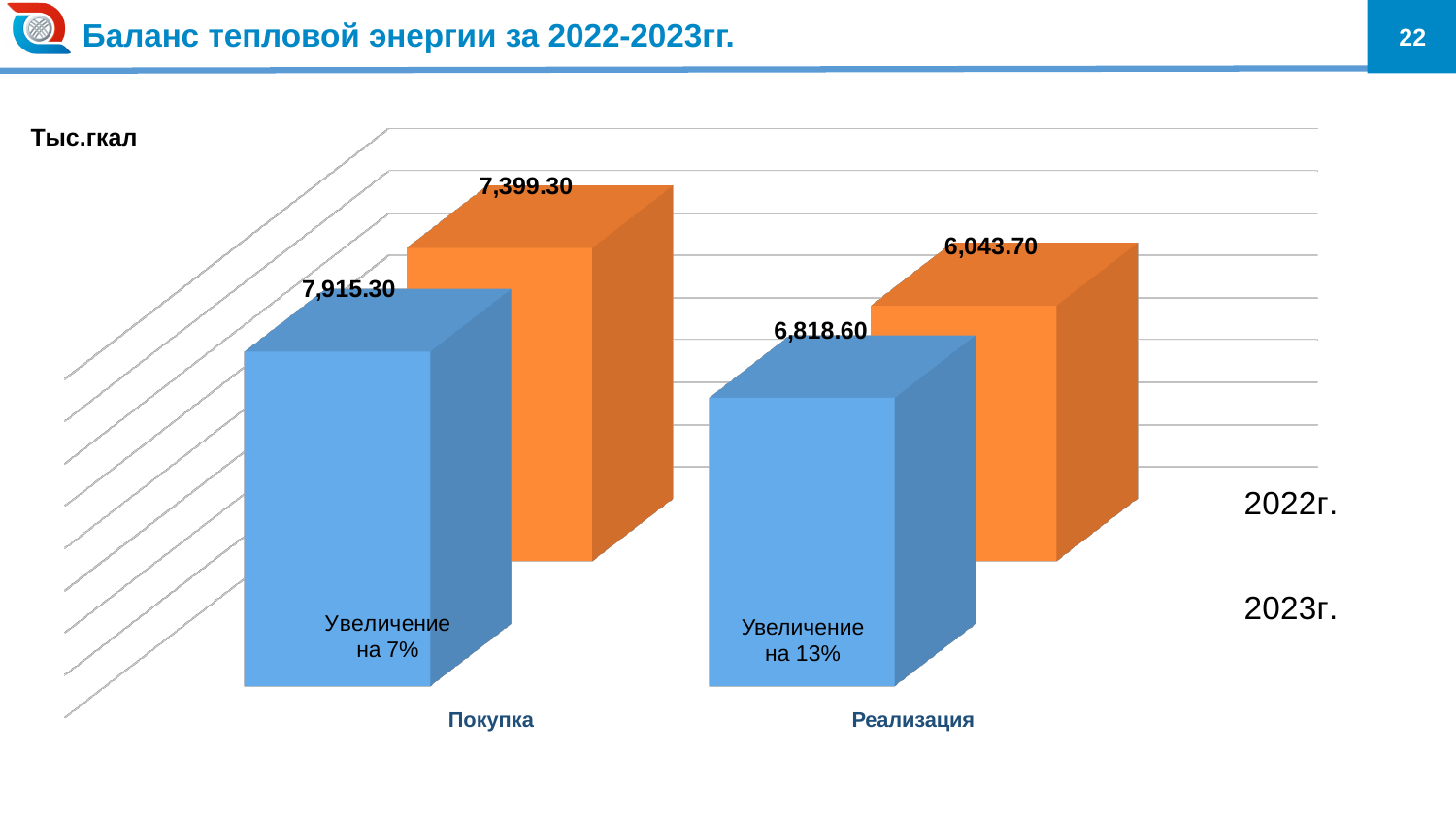
Which bar has the highest value on the chart? Покупка, 2023г. What is the difference between the Реализация values for 2023г. and 2022г.? 774.90 What is the value for Покупка in 2022г.? 7,399.30 What is the value for Реализация in 2022г.? 6,043.70 What is the difference between the Покупка values for 2023г. and 2022г.? 516.00 Which bar has the lowest value on the chart? Реализация, 2022г. How many categories are shown on the x axis? 2 By what percentage did Реализация increase according to the label on the chart? 13% What is the value for Реализация in 2023г.? 6,818.60 What is the value for Покупка in 2023г.? 7,915.30 Which is larger: Покупка in 2022г. or Реализация in 2023г.? Покупка in 2022г. What type of chart is shown on the slide? Bar chart